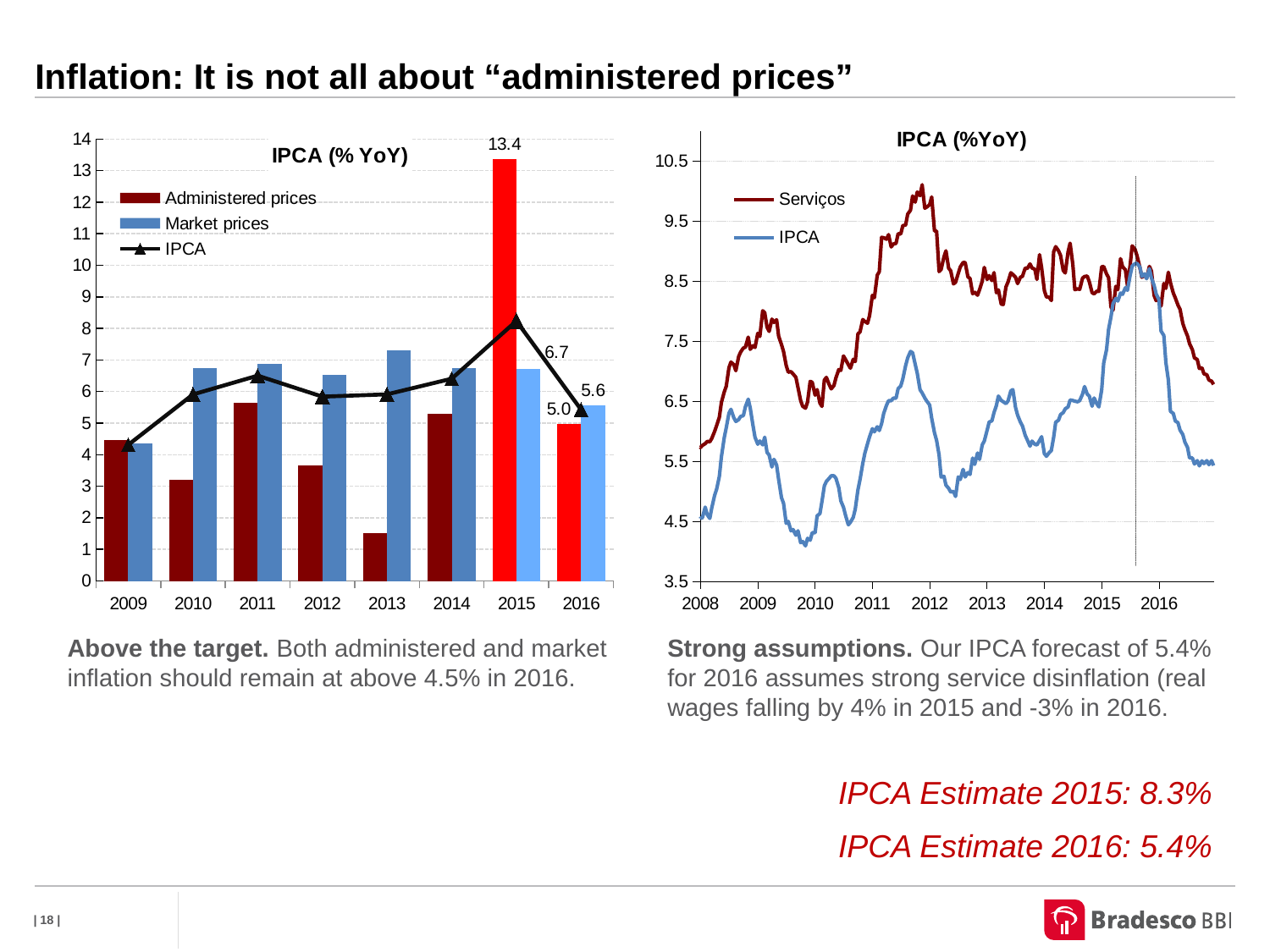
In the left chart (IPCA % YoY bar chart), what is the value for Market prices in 2016? 5.6 In the left chart (IPCA % YoY bar chart), which is larger in 2012: Administered prices or Market prices? Market prices How many years are shown on the x axis of the left chart (IPCA % YoY bar chart)? 8 In the left chart (IPCA % YoY bar chart), what is the difference between Administered prices and Market prices in 2015? 6.7 In the left chart (IPCA % YoY bar chart), which year has the highest Administered prices value? 2015 How many series does the legend of the left chart (IPCA % YoY bar chart) list? 3 What kind of chart is the right chart (IPCA %YoY with Serviços and IPCA)? line chart In the left chart (IPCA % YoY bar chart), what is the value for Market prices in 2015? 6.7 In the left chart (IPCA % YoY bar chart), is the Administered prices value for 2013 greater or less than 2? less In the left chart (IPCA % YoY bar chart), which year has the lowest Administered prices value? 2013 In the left chart (IPCA % YoY bar chart), what is the value for Administered prices in 2016? 5.0 In the left chart (IPCA % YoY bar chart), what is the value for Administered prices in 2015? 13.4